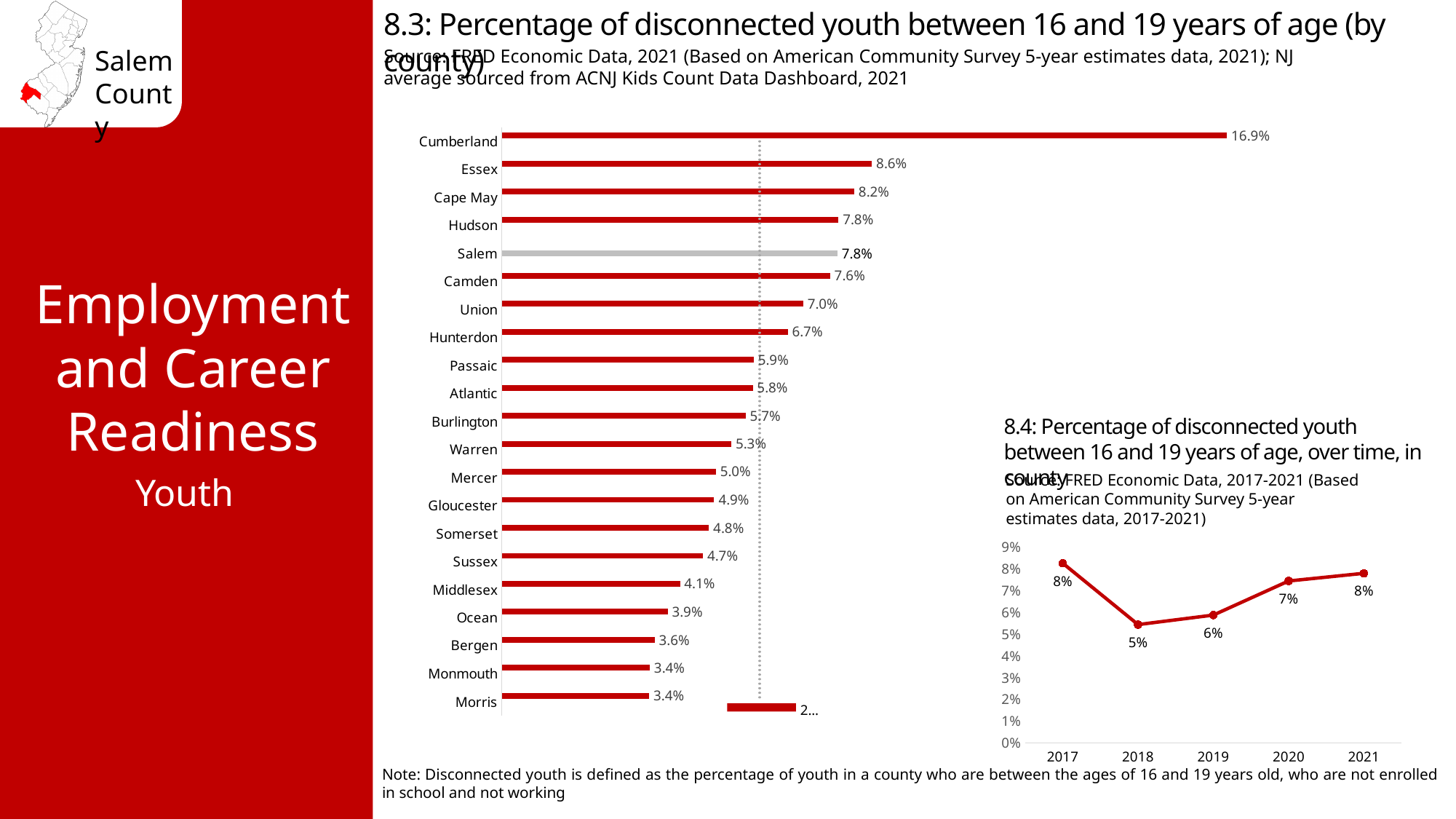
What kind of chart is chart 8.3? Bar chart In chart 8.4, which year has the lowest percentage of disconnected youth? 2018 In chart 8.4, how many years are plotted? 5 In chart 8.3, what colour is the bar for Salem? Grey In chart 8.3, which has a higher value, Essex or Cape May? Essex In chart 8.3, what is the difference between the values for Cumberland and Essex? 8.3 percentage points In chart 8.4, do the values rise or fall from 2018 to 2021? Rise In chart 8.3, which county has the highest percentage of disconnected youth? Cumberland In chart 8.3, what is the value for Middlesex? 4.1% In chart 8.4, what is the percentage of disconnected youth in 2018? 5% In chart 8.3, what is the percentage of disconnected youth for Salem? 7.8% In chart 8.3, how many counties are plotted? 21